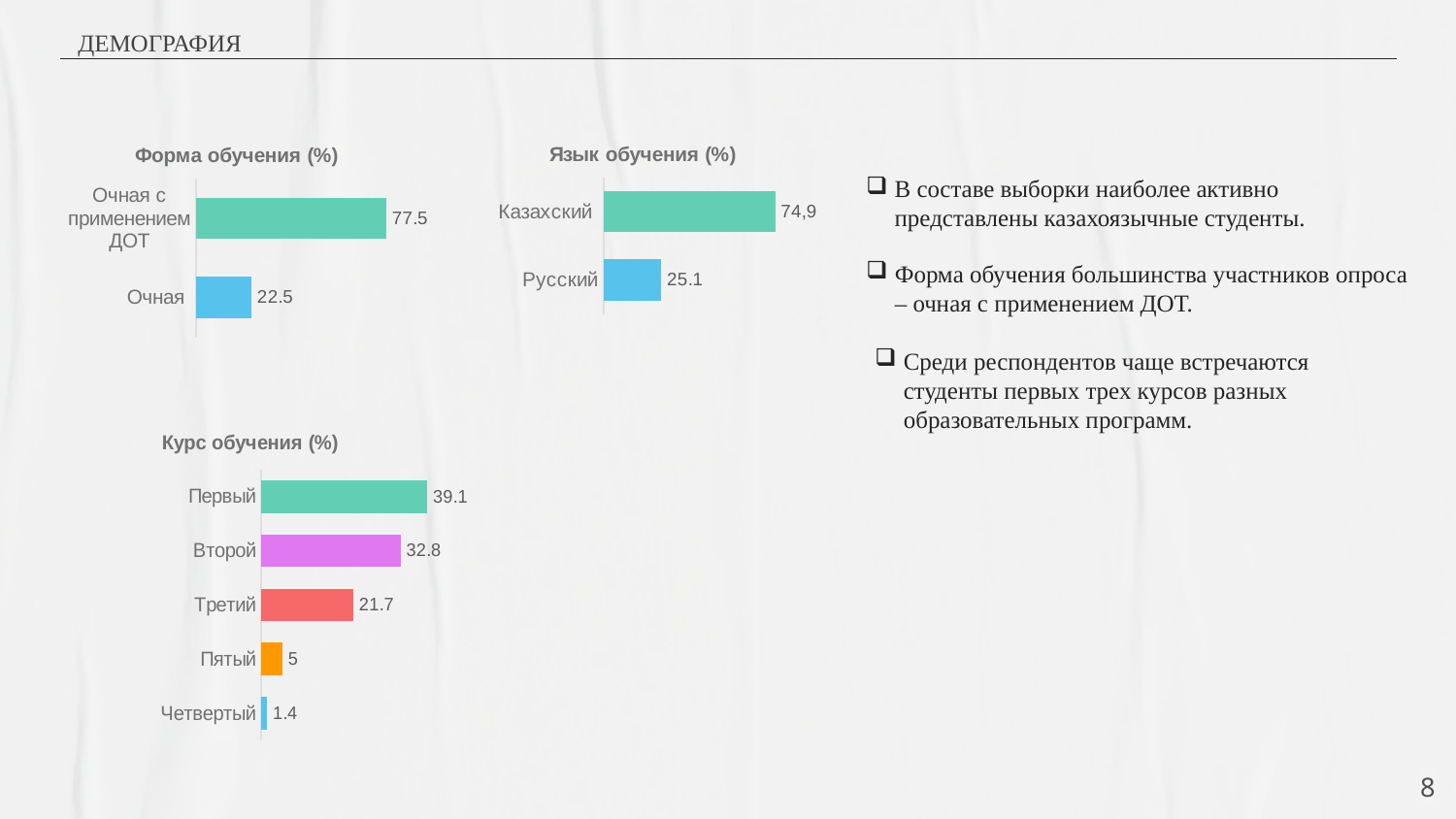
In the chart titled "Язык обучения (%)", which category has the higher value, "Казахский" or "Русский"? Казахский In the chart titled "Курс обучения (%)", which category has the lowest value? Четвертый In the chart titled "Курс обучения (%)", what is the difference between the values for "Первый" and "Второй"? 6.3 In the chart titled "Язык обучения (%)", what is the value for "Русский"? 25.1 What type of chart is the chart titled "Курс обучения (%)"? Bar chart In the chart titled "Язык обучения (%)", what is the value for "Казахский"? 74,9 In the chart titled "Курс обучения (%)", which category has the highest value? Первый In the chart titled "Форма обучения (%)", what is the value for "Очная с применением ДОТ"? 77.5 In the chart titled "Курс обучения (%)", how many categories are shown? 5 In the chart titled "Форма обучения (%)", what is the value for "Очная"? 22.5 In the chart titled "Курс обучения (%)", what is the value for "Третий"? 21.7 In the chart titled "Форма обучения (%)", what is the difference between the values for "Очная с применением ДОТ" and "Очная"? 55